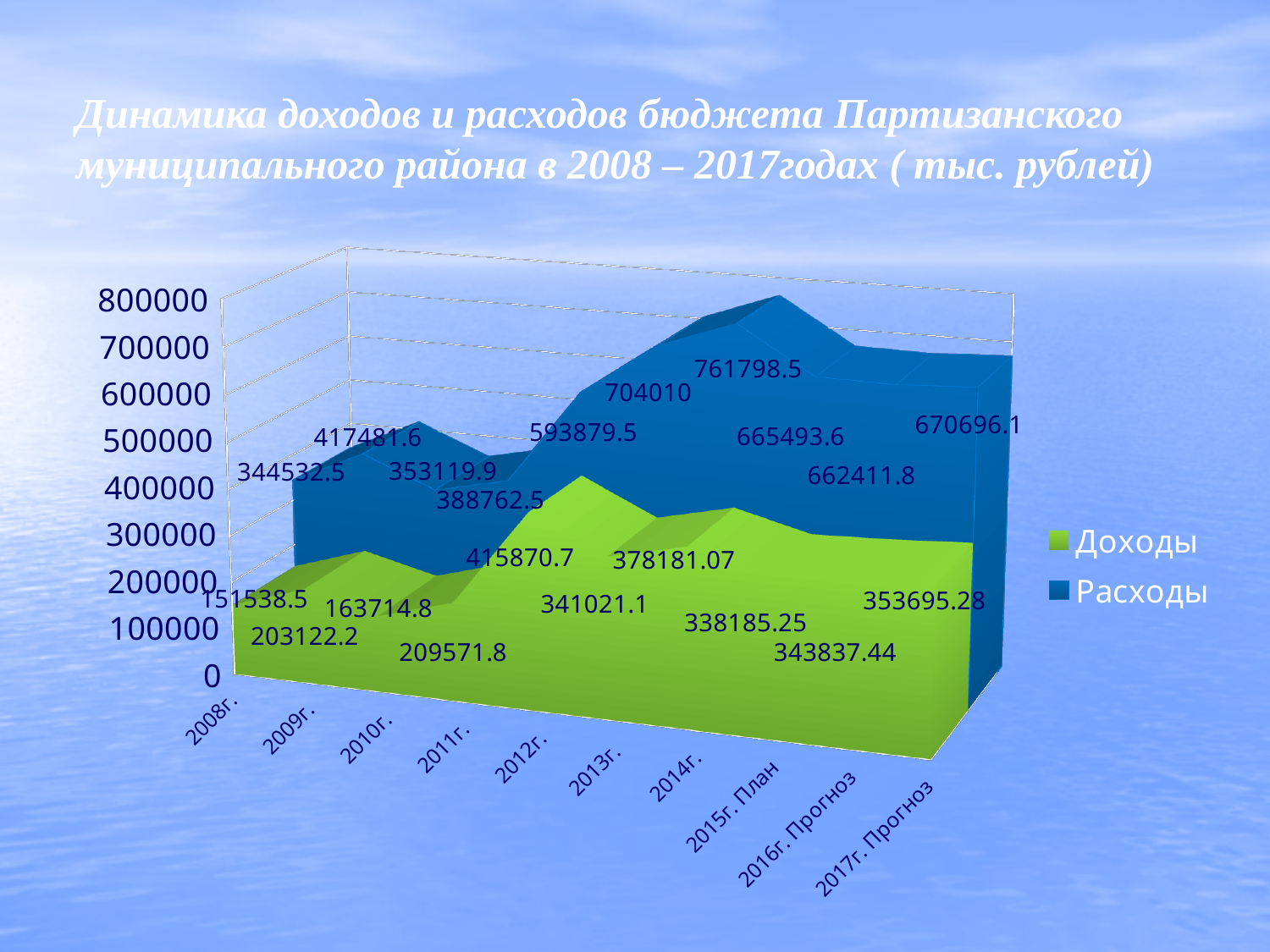
What is the value of Доходы for 2017г. Прогноз? 353695.28 Which is larger in 2013г., Доходы or Расходы? Расходы In which year is Расходы highest? 2014г. What is the difference between Расходы and Доходы in 2014г.? 383617.43 What is the value of Расходы for 2014г.? 761798.5 In which year is Доходы lowest? 2008г. How many series does the legend list? 2 What is the value of Расходы for 2008г.? 344532.5 How many years (categories) are shown on the x axis? 10 Which colour represents Доходы in the legend? Green What kind of chart is shown on the slide? Area chart What is the value of Доходы for 2012г.? 415870.7